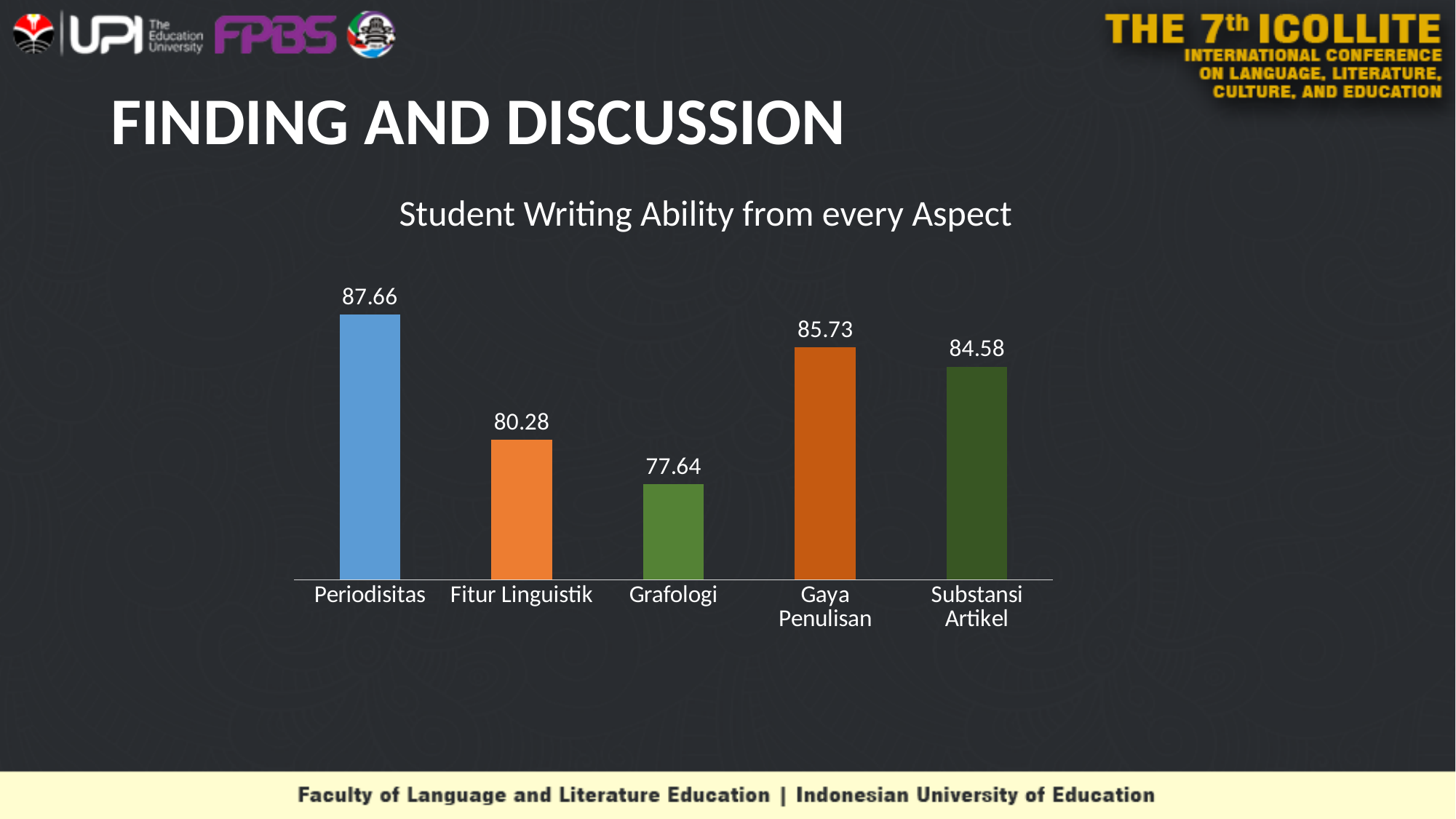
What is the value for Substansi Artikel? 84.58 What is the value for Fitur Linguistik? 80.28 What is the value for Gaya Penulisan? 85.73 Which aspect has the highest value? Periodisitas What is the value for Grafologi? 77.64 What is the difference between the values for Periodisitas and Grafologi? 10.02 How many aspects are shown in the chart? 5 What type of chart is shown on the slide? Bar chart Which aspect has the lowest value? Grafologi What is the value for Periodisitas? 87.66 What is the difference between the values for Gaya Penulisan and Substansi Artikel? 1.15 Which is larger, the value for Fitur Linguistik or the value for Substansi Artikel? Substansi Artikel